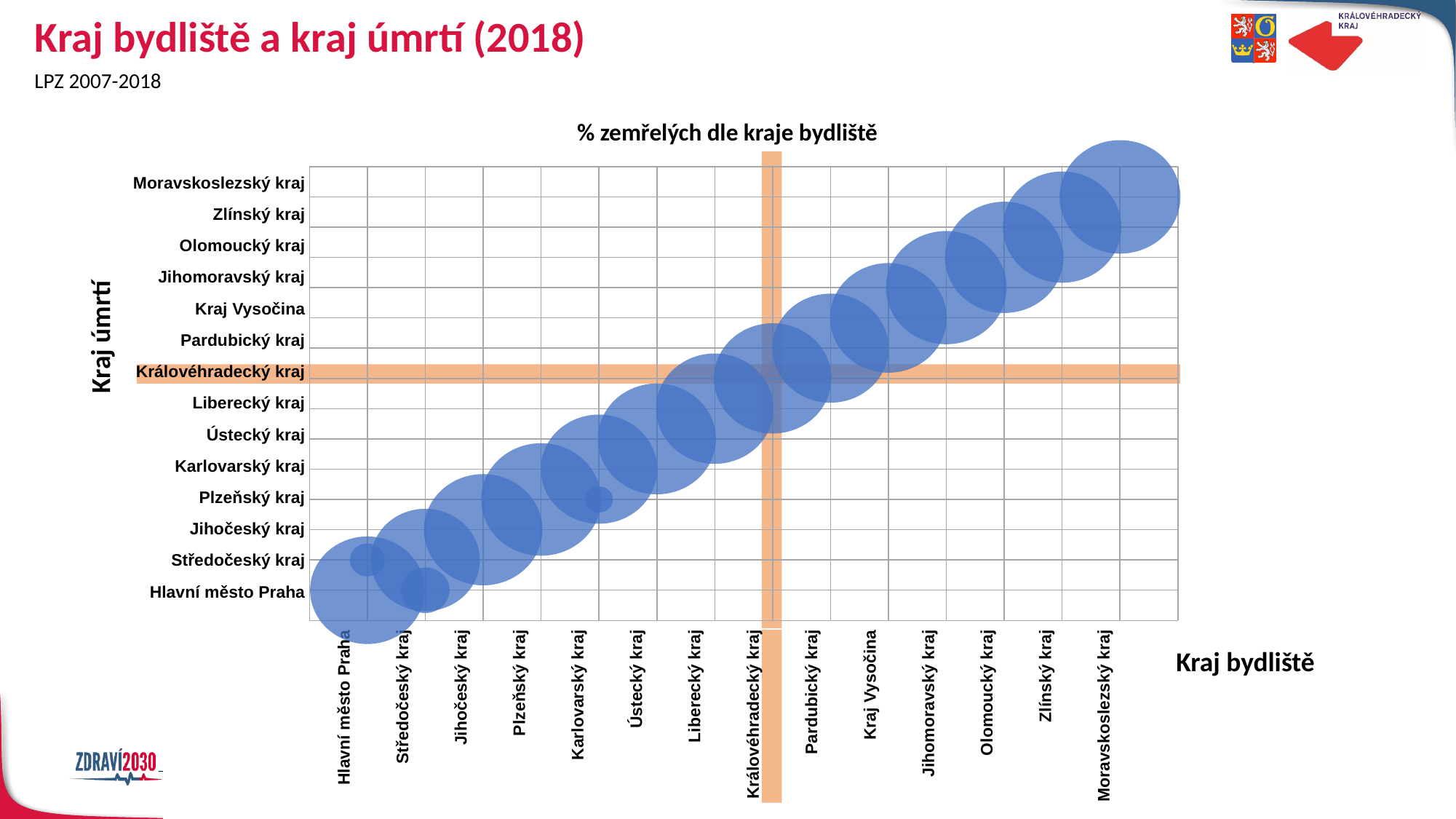
How many regions (kraje) are listed along the x axis (Kraj bydliště)? 14 Which region is highlighted with orange bands on both axes of the chart? Královéhradecký kraj Do the large bubbles lie along a rising or falling diagonal as you move from left to right along the x axis? rising What is the title of the chart? % zemřelých dle kraje bydliště How many regions (kraje) are listed along the y axis (Kraj úmrtí)? 14 What kind of chart is shown on the slide? bubble chart